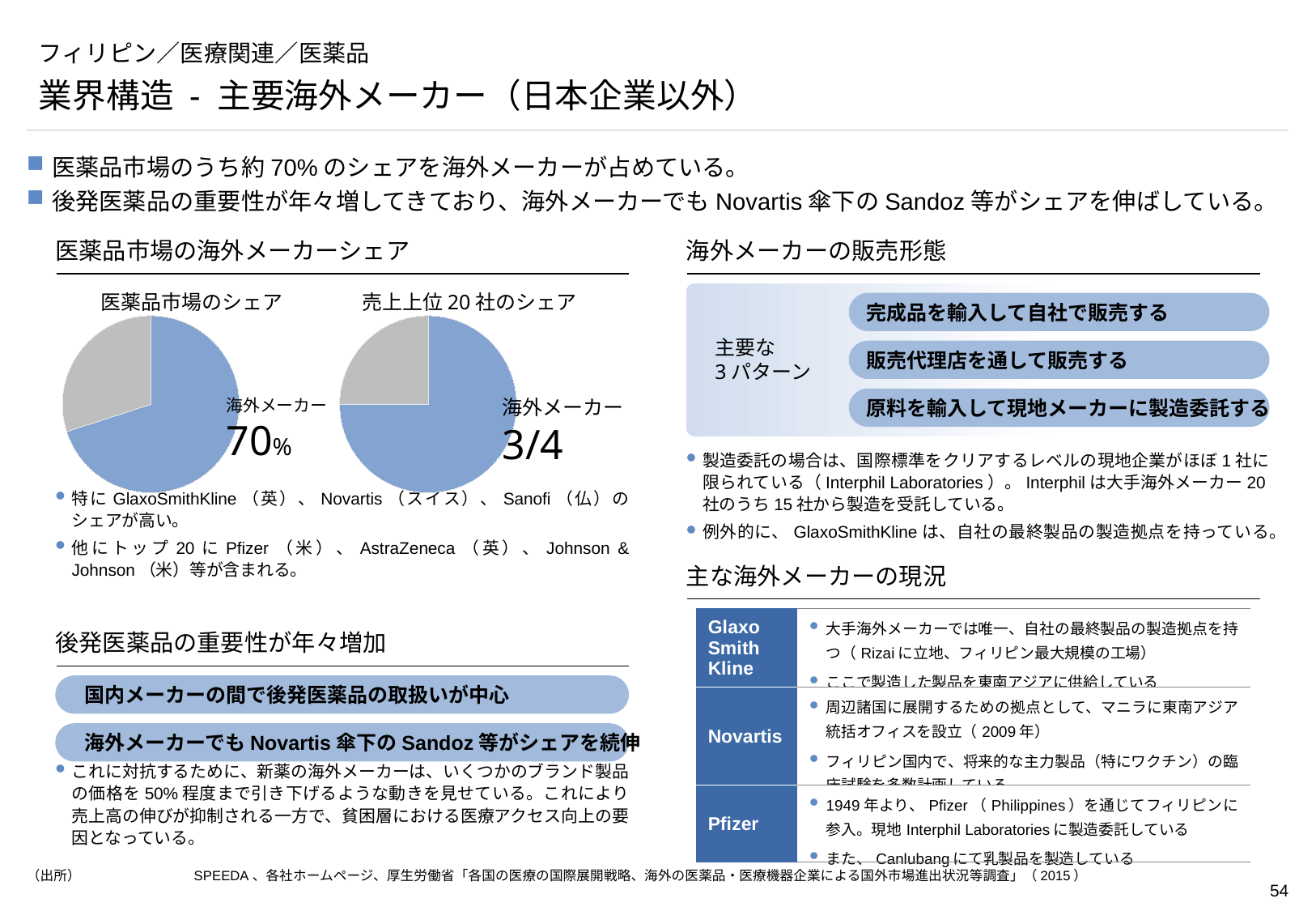
How many slices does the pie chart titled 医薬品市場のシェア have? 2 How many pie charts are shown on the slide? 2 In the pie chart titled 医薬品市場のシェア, is the 海外メーカー slice larger or smaller than the other slice? Larger How many slices does the pie chart titled 売上上位20社のシェア have? 2 In the pie chart titled 医薬品市場のシェア, what share is shown for 海外メーカー? 70% What colour is the 海外メーカー slice in the two pie charts? Blue What kind of chart is used under the heading 医薬品市場の海外メーカーシェア? Pie chart In the pie chart titled 医薬品市場のシェア, is the share for 海外メーカー greater or less than 50%? greater What share of the pie titled 医薬品市場のシェア does the 海外メーカー slice represent? 70% What is the title of the left pie chart under 医薬品市場の海外メーカーシェア? 医薬品市場のシェア In the pie chart titled 売上上位20社のシェア, which slice is larger: the 海外メーカー slice or the grey slice? 海外メーカー In the pie chart titled 売上上位20社のシェア, what share is shown for 海外メーカー? 3/4